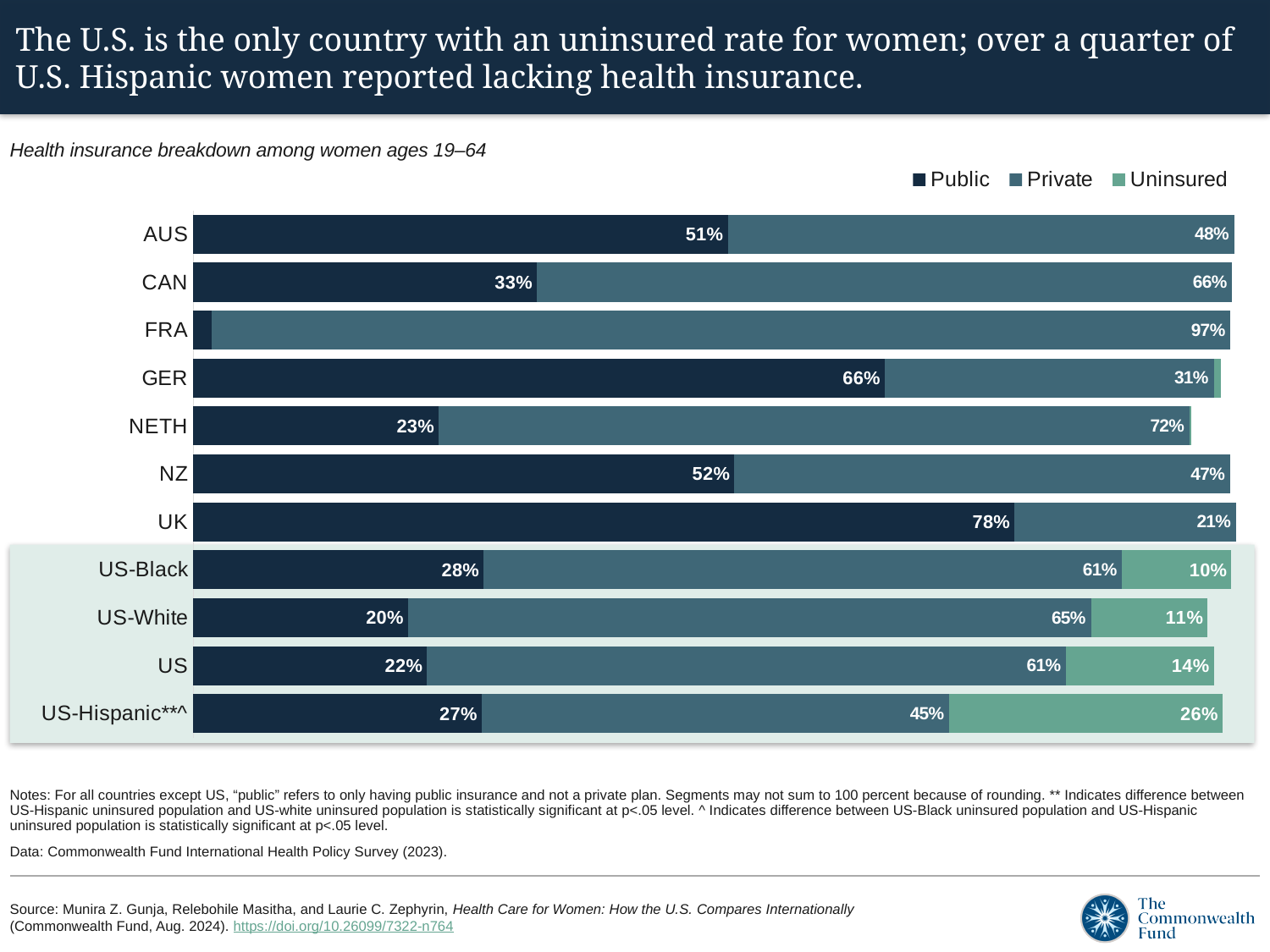
What is the difference between the Uninsured value for US-Hispanic**^ and the Uninsured value for US? 12 percentage points What is the Private value for NETH? 72% Which country or group has the highest Public value? UK How many series does the legend list? 3 Which country or group has the highest Private value? FRA Which is larger, the Private value for CAN or the Private value for AUS? CAN What is the Uninsured value for US-Hispanic**^? 26% Among the US groups, which has the lowest Uninsured value? US-Black How many countries or groups are shown on the chart? 11 What type of chart is shown on the slide? Stacked bar chart What is the Public value for the UK? 78% What is the total of the three labeled segments for US-Black? 99%